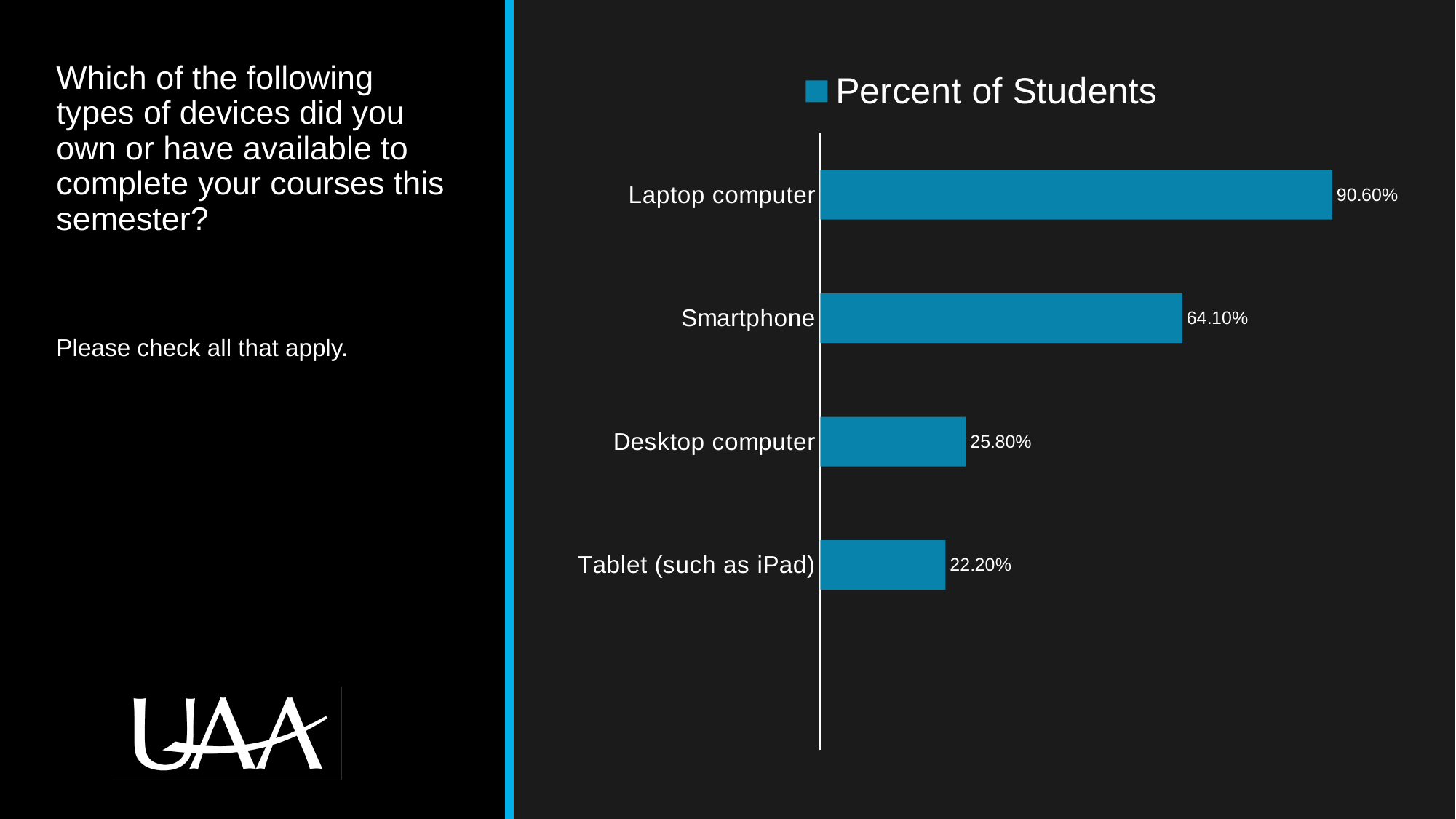
What is the value for Tablet (such as iPad)? 22.20% What is the difference between the Desktop computer and Tablet (such as iPad) values? 3.60% What percent of students have a laptop computer available? 90.60% What percent of students have a desktop computer? 25.80% What series name does the chart legend show? Percent of Students What kind of chart is shown on the slide? Bar chart What is the value for Smartphone? 64.10% Which device type has the highest percent of students? Laptop computer Which is larger, the value for Smartphone or the value for Desktop computer? Smartphone What is the difference between the Laptop computer and Smartphone values? 26.50% Which device type has the lowest percent of students? Tablet (such as iPad) How many device categories are shown in the chart? 4